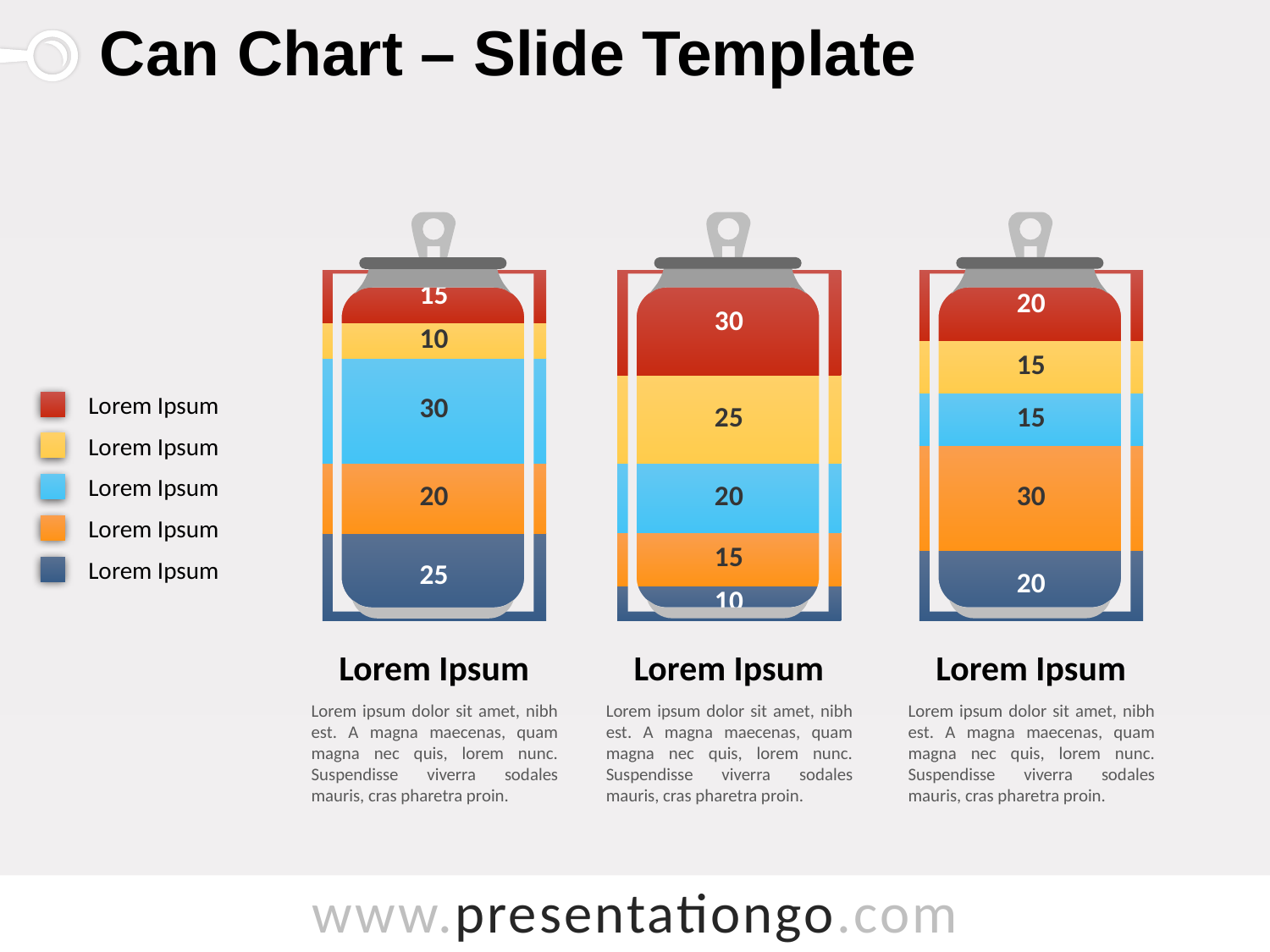
What is the total of all segments in the middle can? 100 Which is larger: the dark blue segment in the left can or the dark blue segment in the right can? The left can (25) What is the total of all segments in the left can? 100 In the left can, what is the value of the red segment at the top? 15 In the middle can, which segment has the smallest value? The dark blue segment at the bottom (10) What kind of chart is shown on the slide? Stacked bar chart (styled as cans) In the right can, what is the value of the orange segment? 30 How many entries does the legend list? 5 In the left can, which segment has the largest value? The light blue segment (30) How many segments does each can contain? 5 In the middle can, what is the value of the yellow segment? 25 What is the difference between the red segment in the middle can and the red segment in the left can? 15